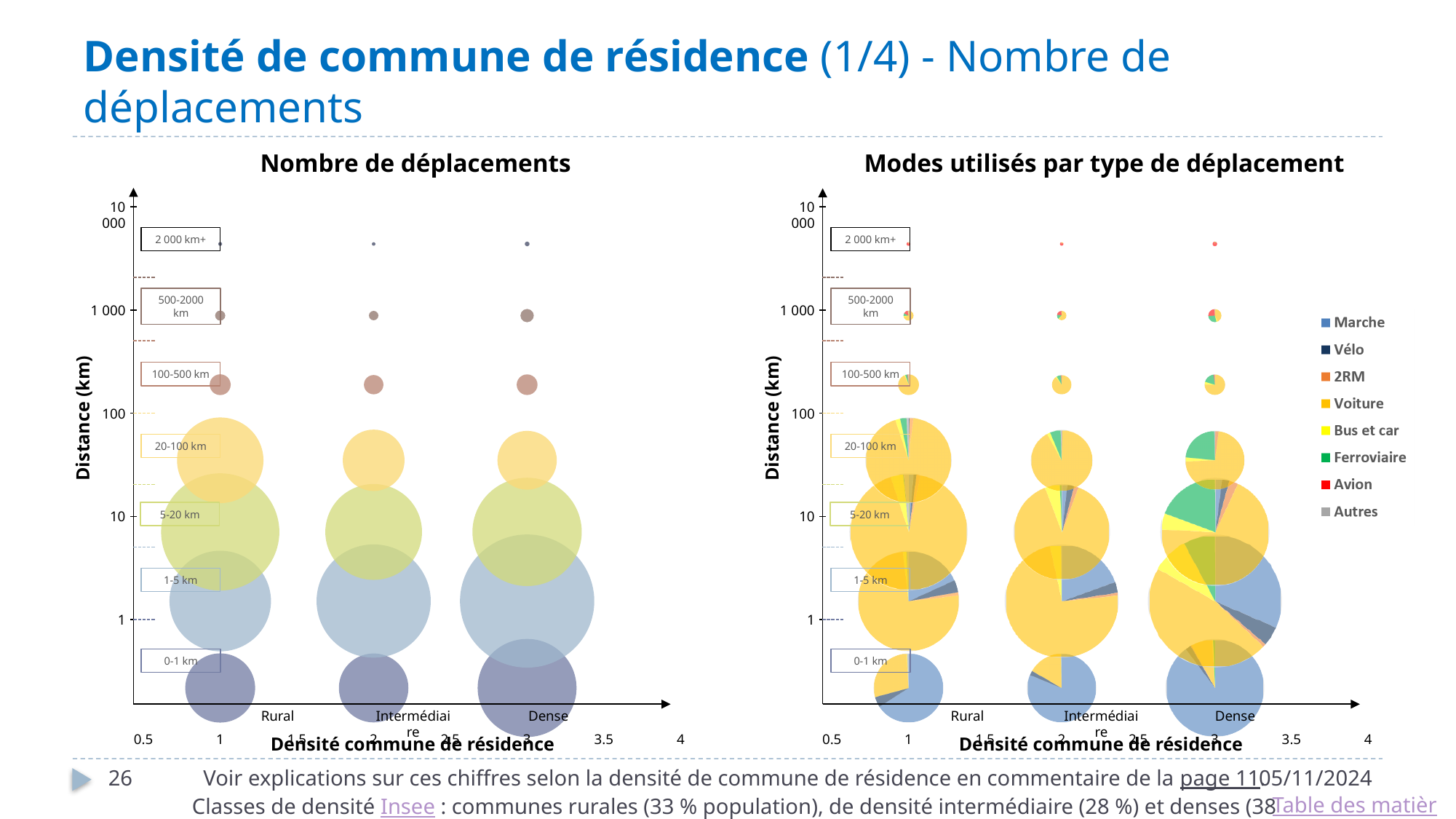
In the left chart "Nombre de déplacements", how many distance bands are labelled along the y axis? 7 In the left chart "Nombre de déplacements", which distance band has the smallest bubble for Rural? 2 000 km+ What is the title of the right chart? Modes utilisés par type de déplacement What is the y-axis label of the left chart "Nombre de déplacements"? Distance (km) In the left chart "Nombre de déplacements", which distance band has the largest bubble for Dense? 1-5 km In the right chart "Modes utilisés par type de déplacement", for Rural 1-5 km, which mode has the larger share: Voiture or Marche? Voiture In the left chart "Nombre de déplacements", for Rural, which bubble is larger: 1-5 km or 0-1 km? 1-5 km In the right chart "Modes utilisés par type de déplacement", how many modes does the legend list? 8 In the right chart "Modes utilisés par type de déplacement", for Dense 0-1 km, which mode has the larger share: Marche or Voiture? Marche What kind of chart is the left chart titled "Nombre de déplacements"? bubble chart In the left chart "Nombre de déplacements", how many density categories are shown along the x axis? 3